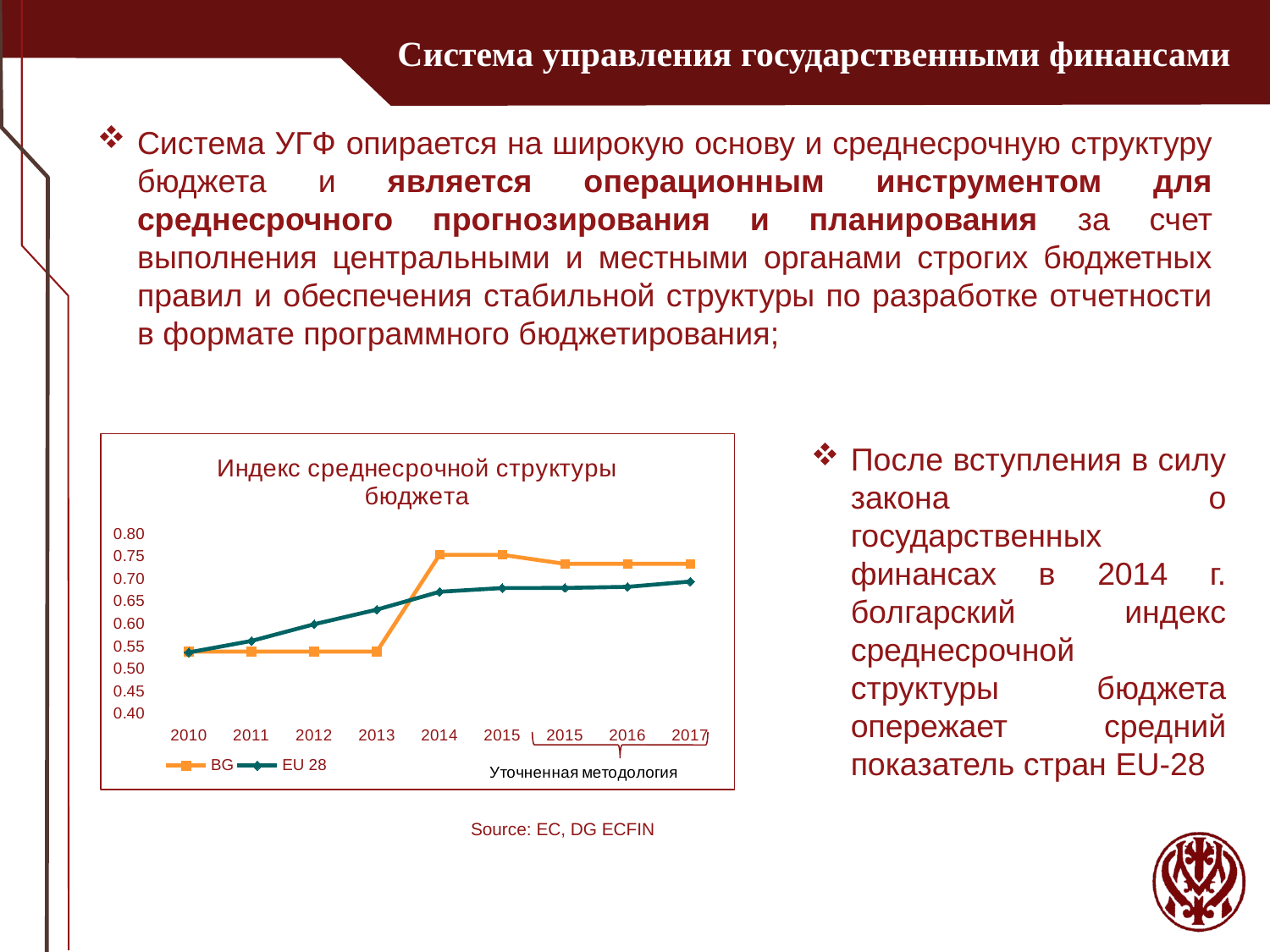
In 2017, which series has the higher value, BG or EU 28? BG What is the title of the chart? Индекс среднесрочной структуры бюджета Is the value for EU 28 in 2013 greater or less than 0.60? greater Is the value for BG in 2012 greater or less than 0.60? less How many series does the legend of the chart list? 2 How many points are plotted along the x axis for each series? 9 What kind of chart is shown on the slide? line chart Which series are listed in the chart's legend? BG and EU 28 Is the value for EU 28 in 2010 greater or less than 0.60? less In 2012, which series has the higher value, BG or EU 28? EU 28 Does the EU 28 series rise or fall from 2010 to 2017? rise